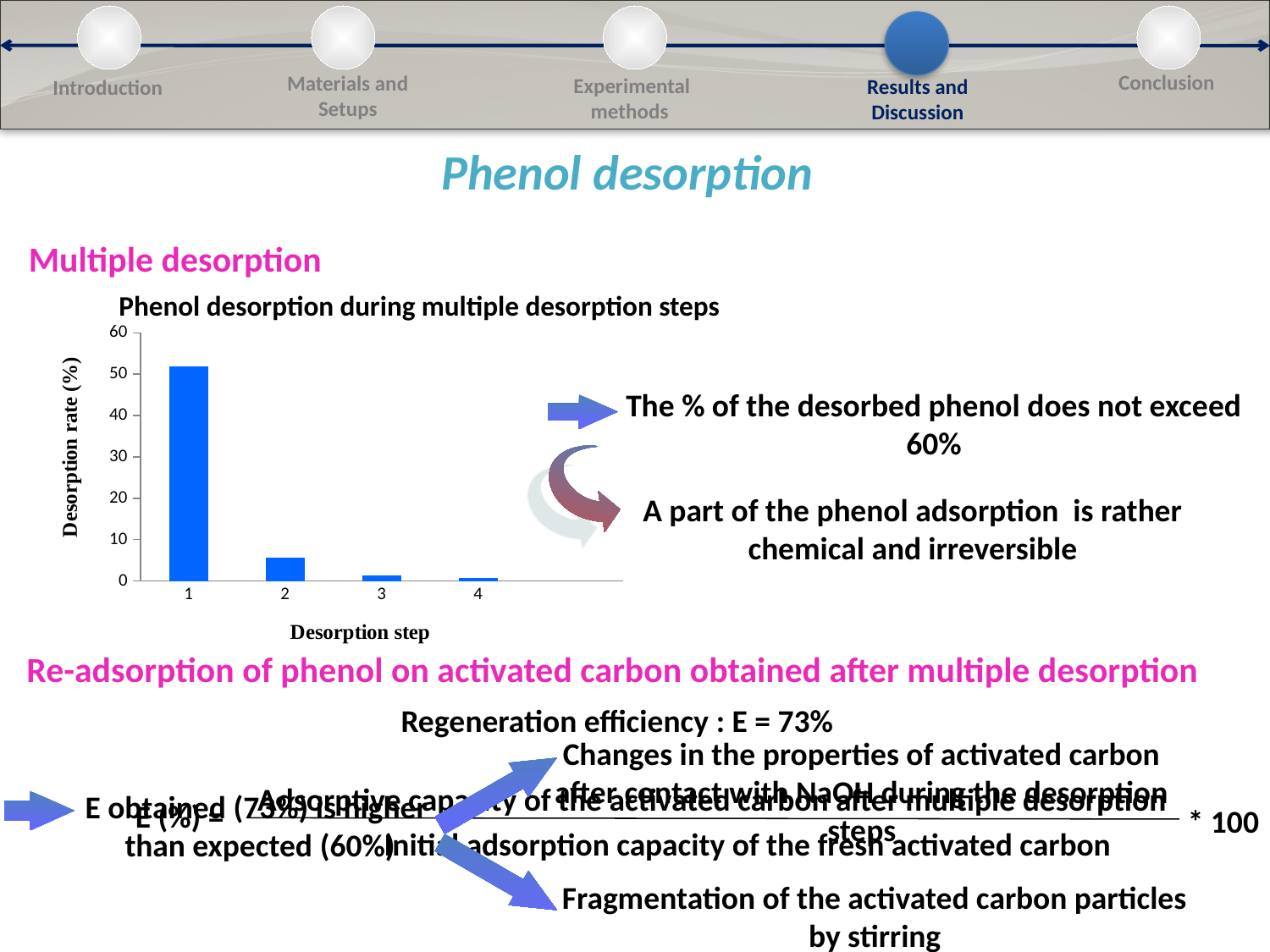
Which desorption step has the highest desorption rate? 1 Is the desorption rate for desorption step 3 greater or less than 10? less Does the desorption rate rise or fall as the desorption step increases from 1 to 4? fall Is the desorption rate for desorption step 1 greater or less than 40? greater Which has a higher desorption rate, desorption step 1 or desorption step 2? 1 Is the desorption rate for desorption step 1 greater or less than 60? less How many desorption steps are plotted in the chart? 4 Which has a higher desorption rate, desorption step 2 or desorption step 3? 2 What is the label of the vertical axis of the chart? Desorption rate (%) What is the title of the chart? Phenol desorption during multiple desorption steps What type of chart is shown on the slide? bar chart